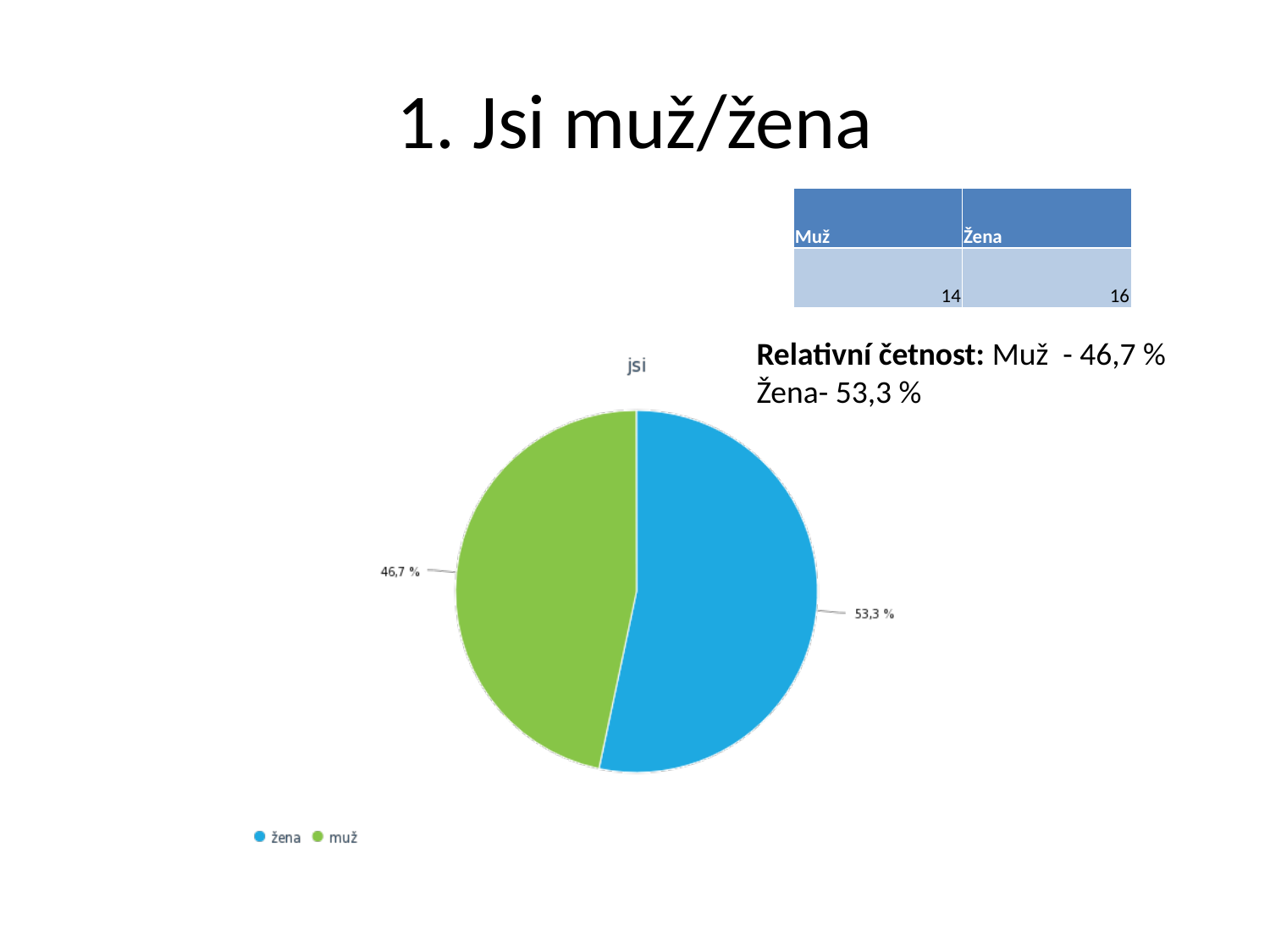
Which slice of the pie chart is the largest? žena Which slice of the pie chart is the smallest? muž What is the difference in percentage points between the žena and muž slices? 6,6 % How many entries does the legend of the pie chart list? 2 Which slice is larger, žena or muž? žena Is the share of the muž slice greater or less than 50 %? less What is the title of the pie chart? jsi What share of the pie does the muž slice represent? 46,7 % What share of the pie does the žena slice represent? 53,3 % How many slices does the pie chart have? 2 What kind of chart is shown on the slide? pie chart What colour is the žena slice in the pie chart? blue